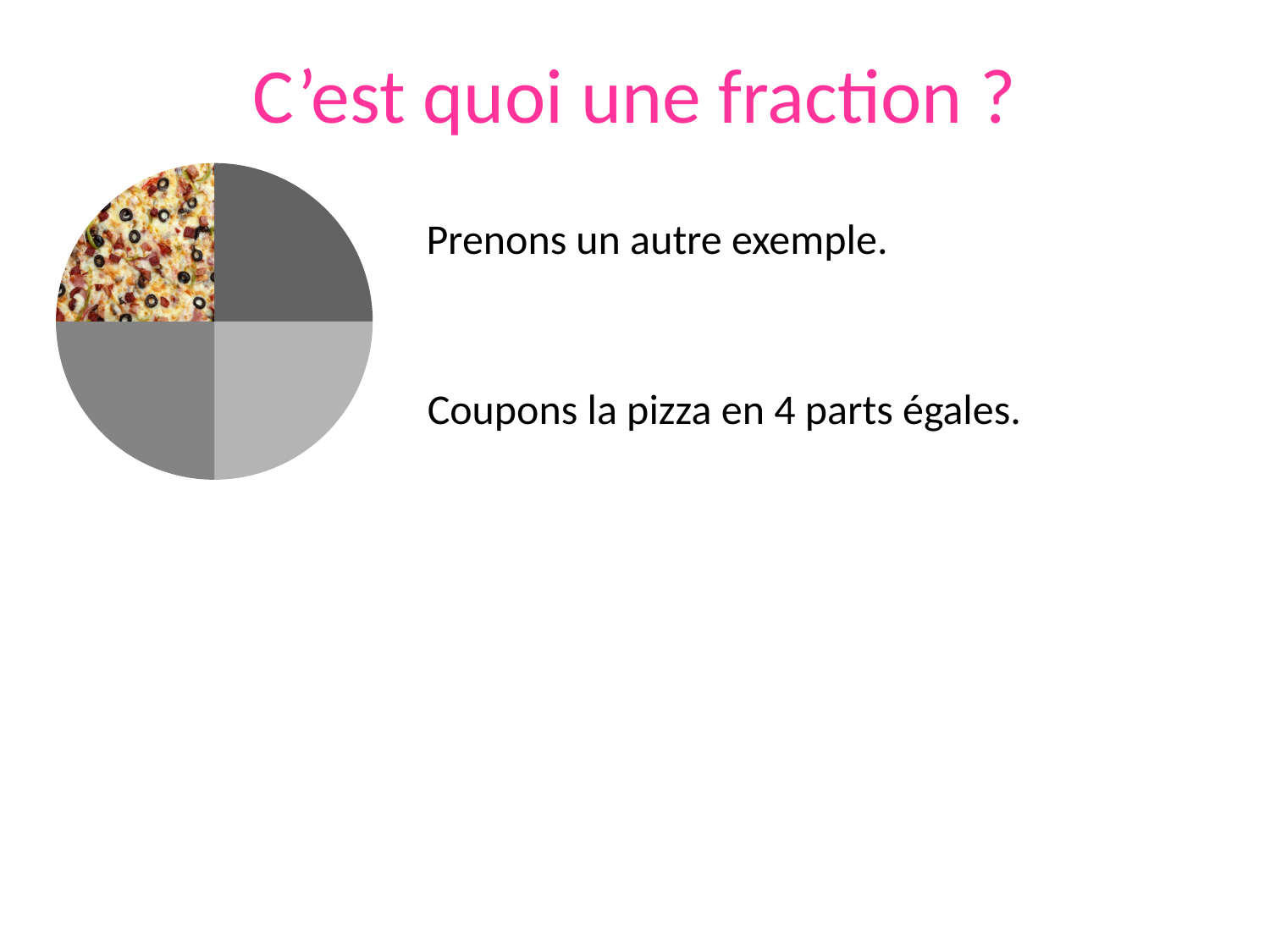
According to the slide text, into how many equal parts is the pizza cut? 4 What kind of chart is shown on the slide? pie chart How many slices of the pie chart are filled with grey rather than the pizza image? 3 How many slices does the pie chart have? 4 What share of the pie does the slice showing the pizza image represent? 1/4 Are the slices of the pie chart equal in size? yes